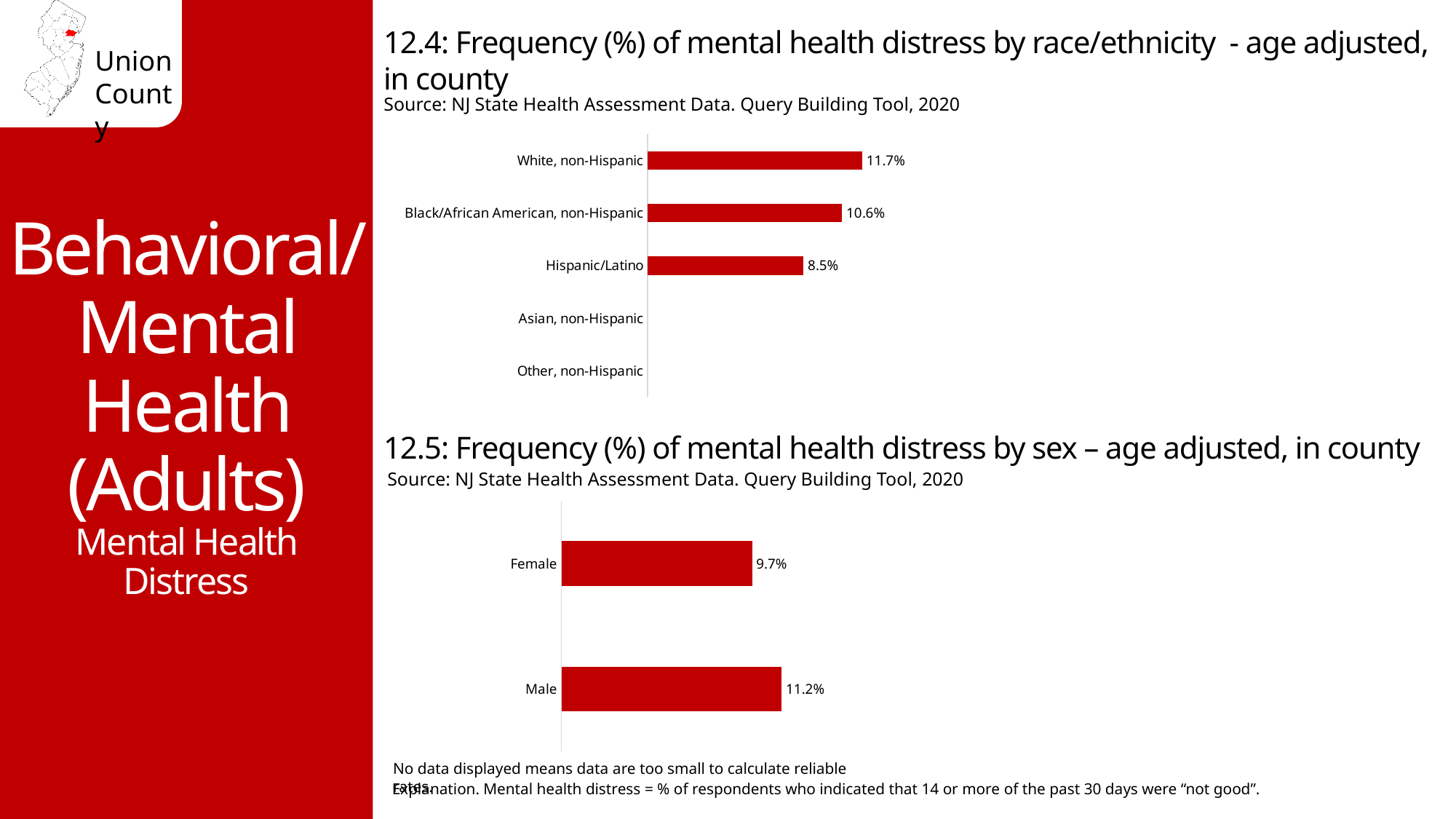
In chart 12.5 (mental health distress by sex), what is the value for Male? 11.2% In chart 12.4 (mental health distress by race/ethnicity), what is the value for White, non-Hispanic? 11.7% In chart 12.4 (mental health distress by race/ethnicity), what is the value for Black/African American, non-Hispanic? 10.6% In chart 12.4 (mental health distress by race/ethnicity), which categories have no bar displayed? Asian, non-Hispanic and Other, non-Hispanic In chart 12.5 (mental health distress by sex), what is the value for Female? 9.7% In chart 12.4 (mental health distress by race/ethnicity), how many categories are listed on the axis? 5 In chart 12.5 (mental health distress by sex), what is the difference between the Male and Female values? 1.5% In chart 12.4 (mental health distress by race/ethnicity), which category has the highest value? White, non-Hispanic In chart 12.4 (mental health distress by race/ethnicity), what is the value for Hispanic/Latino? 8.5% In chart 12.4 (mental health distress by race/ethnicity), what is the difference between the White, non-Hispanic and Hispanic/Latino values? 3.2% In chart 12.5 (mental health distress by sex), which is larger, the Male or the Female value? Male What kind of chart is chart 12.5 (mental health distress by sex)? Bar chart